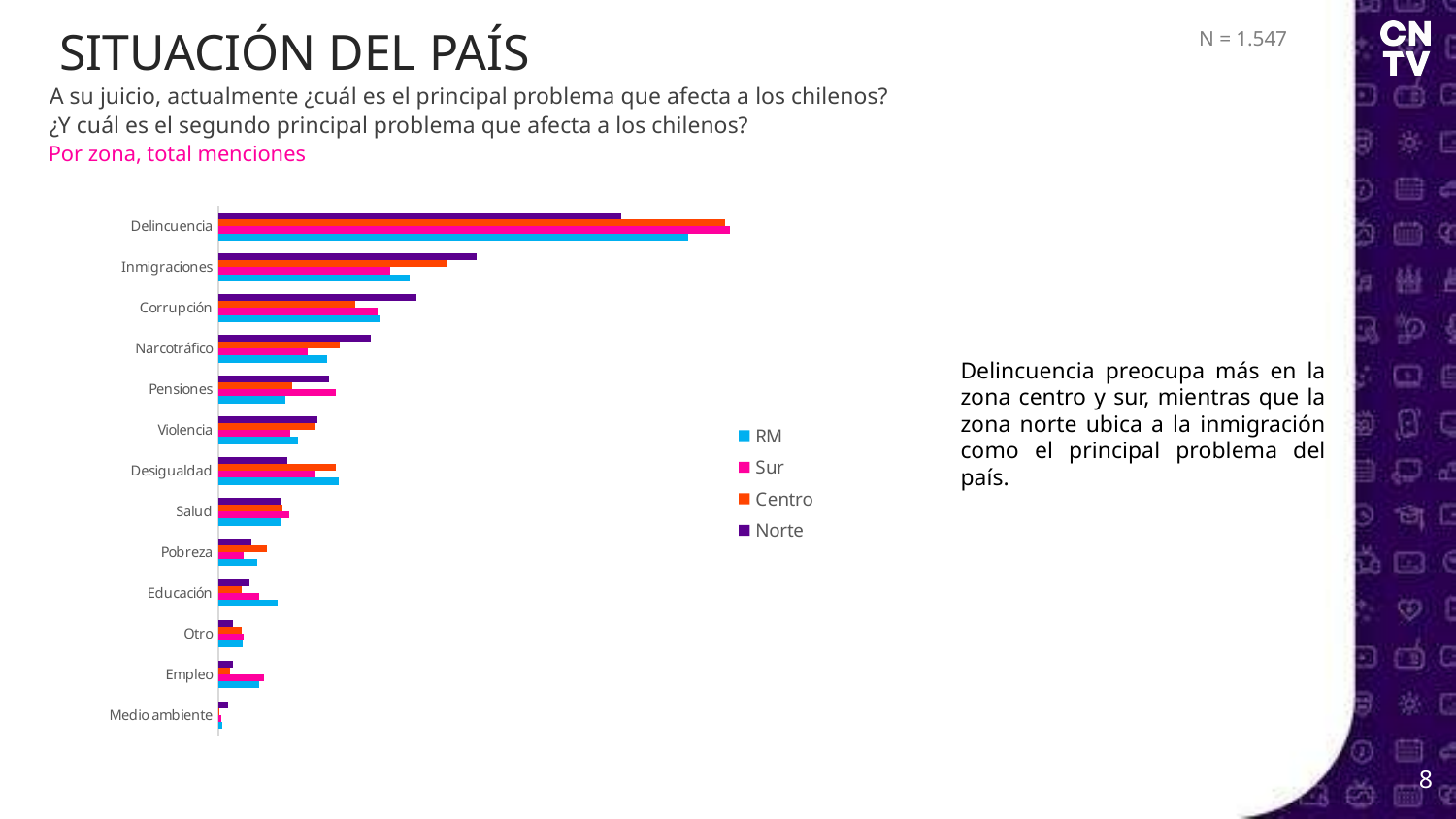
For Empleo, is the bar for Sur or for Norte longer? Sur What kind of chart is shown on the slide? Bar chart How many series does the chart legend list? 4 For Inmigraciones, is the bar for Norte or for RM longer? Norte For Educación, is the bar for RM or for Norte longer? RM Which colour represents the Norte series in the chart? Purple What are the four series listed in the chart legend? RM, Sur, Centro, Norte Which category has the shortest bars overall on the chart? Medio ambiente For Inmigraciones, which zone has the longest bar? Norte For Delincuencia, which zone has the shortest bar? Norte How many categories (problems) are listed on the chart? 13 Which category has the longest bars overall on the chart? Delincuencia